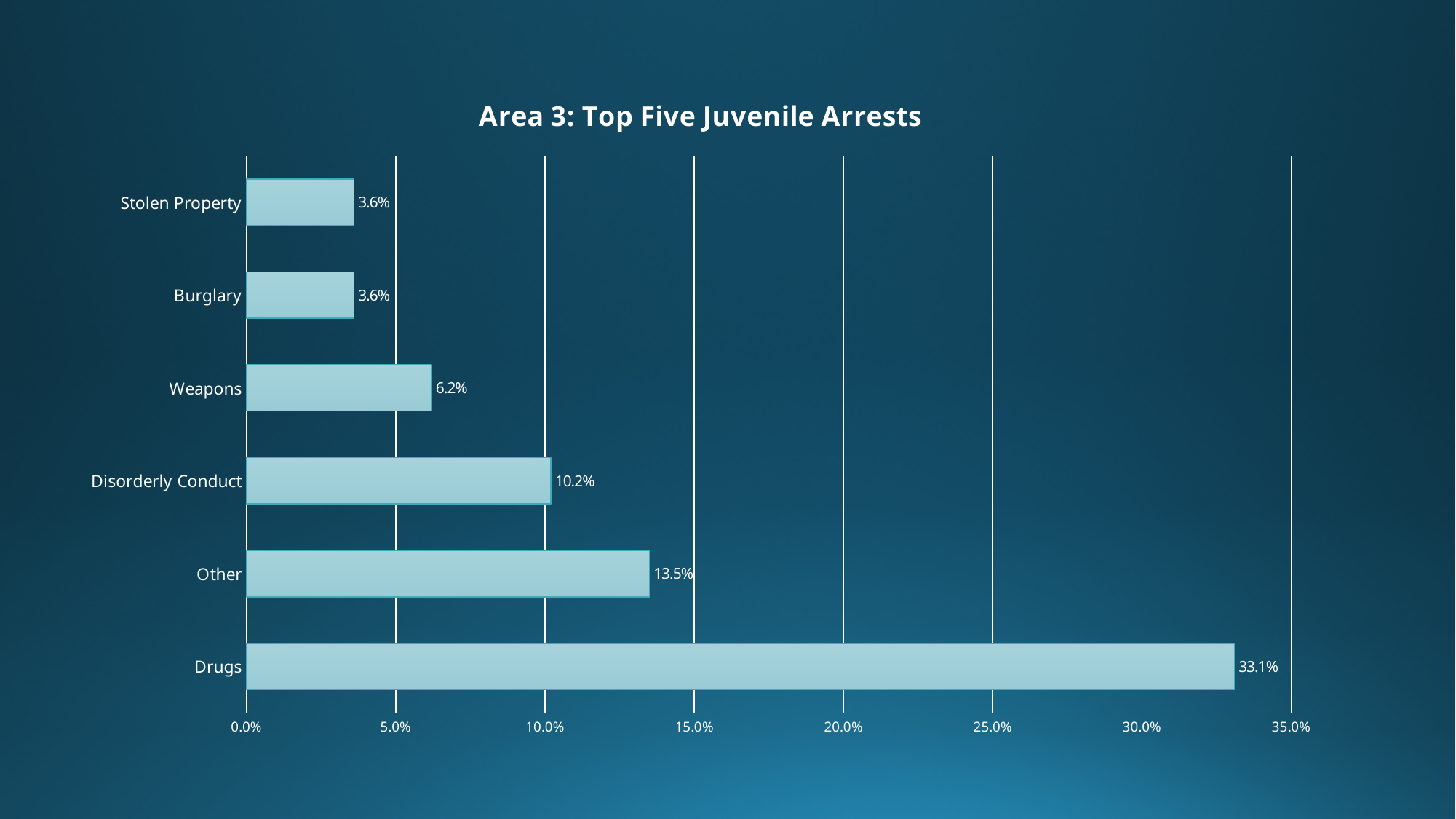
What is the value for Other? 13.5% What is the title of the chart? Area 3: Top Five Juvenile Arrests What is the value for Weapons? 6.2% Is the value for Drugs greater or less than 30.0%? greater What is the value for Disorderly Conduct? 10.2% Which is larger, the value for Other or the value for Disorderly Conduct? Other What is the difference between the values for Drugs and Other? 19.6% What is the difference between the values for Disorderly Conduct and Weapons? 4.0% How many categories are shown in the chart? 6 Which category has the highest value? Drugs What is the value for Drugs? 33.1% What kind of chart is shown on the slide? bar chart